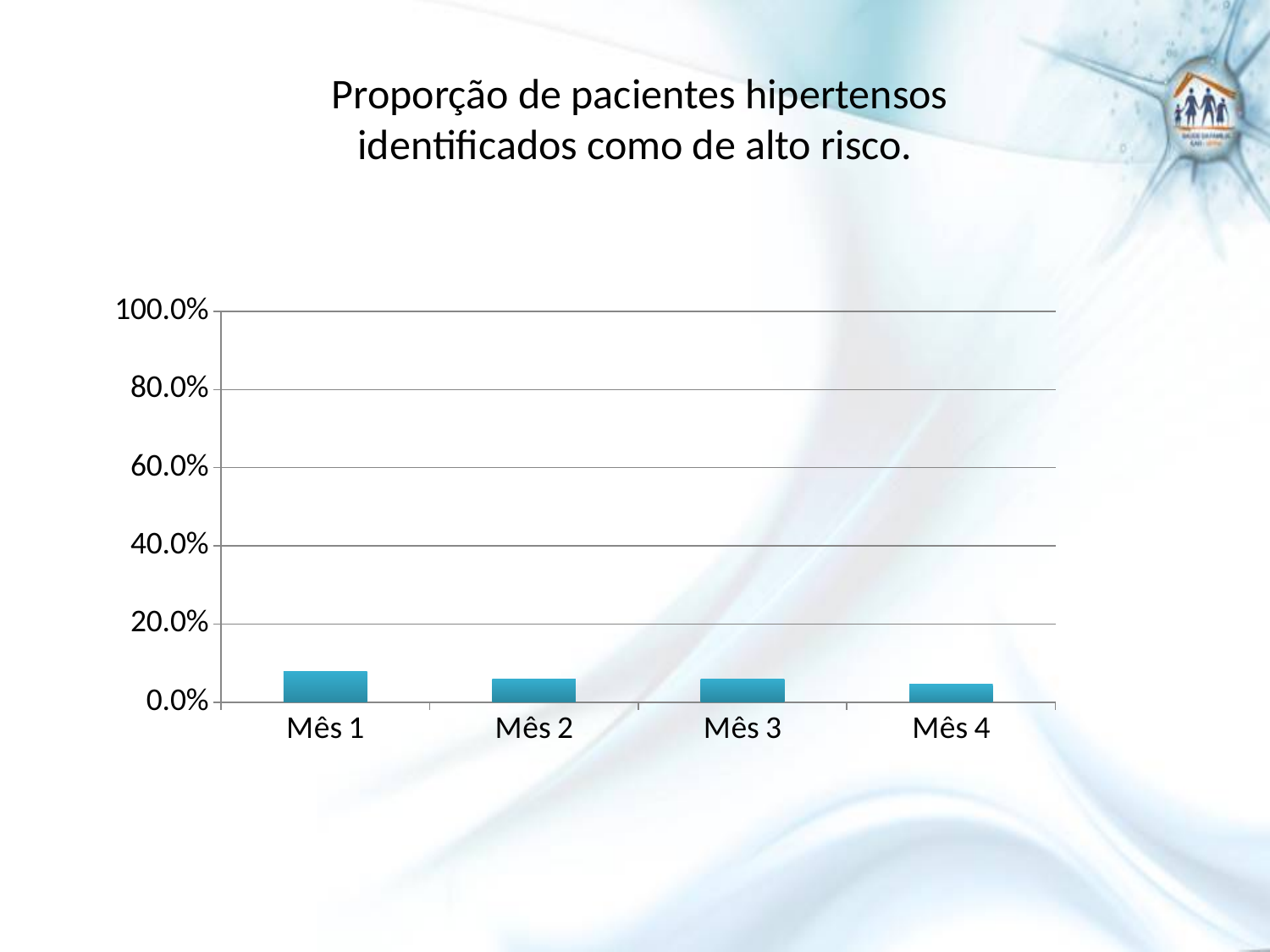
Which is larger, the value for Mês 1 or the value for Mês 4? Mês 1 How many categories are shown on the x axis? 4 Is the value for Mês 4 greater or less than 20%? less Which month has the highest value? Mês 1 What is the title of the chart? Proporção de pacientes hipertensos identificados como de alto risco. Do the values generally rise or fall from Mês 1 to Mês 4? fall Is the value for Mês 2 greater or less than 40%? less What is the highest value shown on the y axis? 100.0% Is the value for Mês 1 greater or less than 20%? less What kind of chart is shown on the slide? bar chart